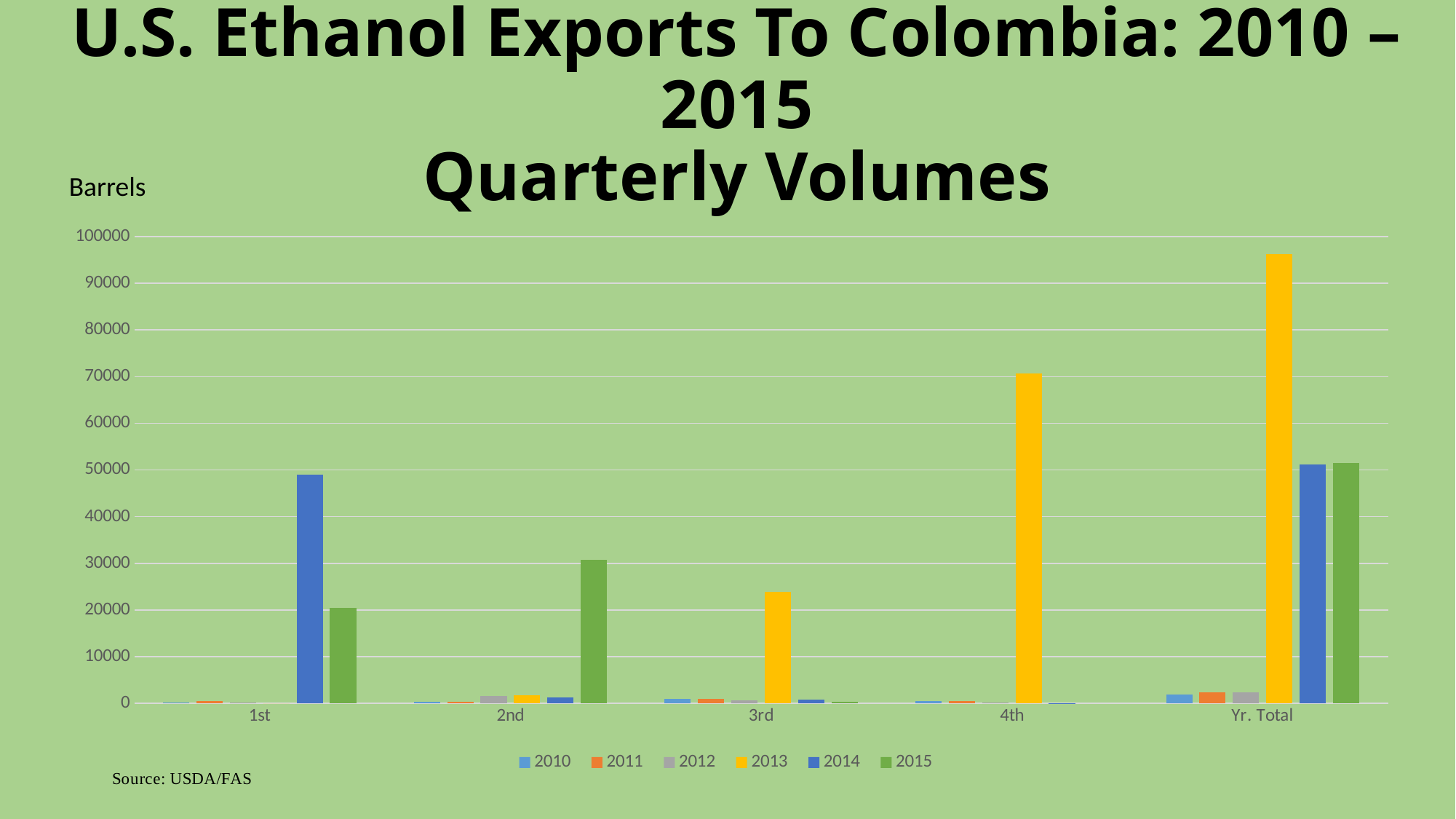
Is the Yr. Total value for 2013 greater or less than 90000? greater How many categories are shown along the x axis? 5 Is the 2nd quarter value for 2015 greater or less than 40000? less Is the 3rd quarter value for 2013 greater or less than 30000? less In the 1st quarter category, which is larger: the value for 2014 or the value for 2015? 2014 What kind of chart is shown on the slide? bar chart How many series does the legend list? 6 In the Yr. Total category, which year has the highest bar? 2013 What unit label is shown above the vertical axis? Barrels In the 4th quarter category, which year has the highest bar? 2013 In the 1st quarter category, which year has the highest bar? 2014